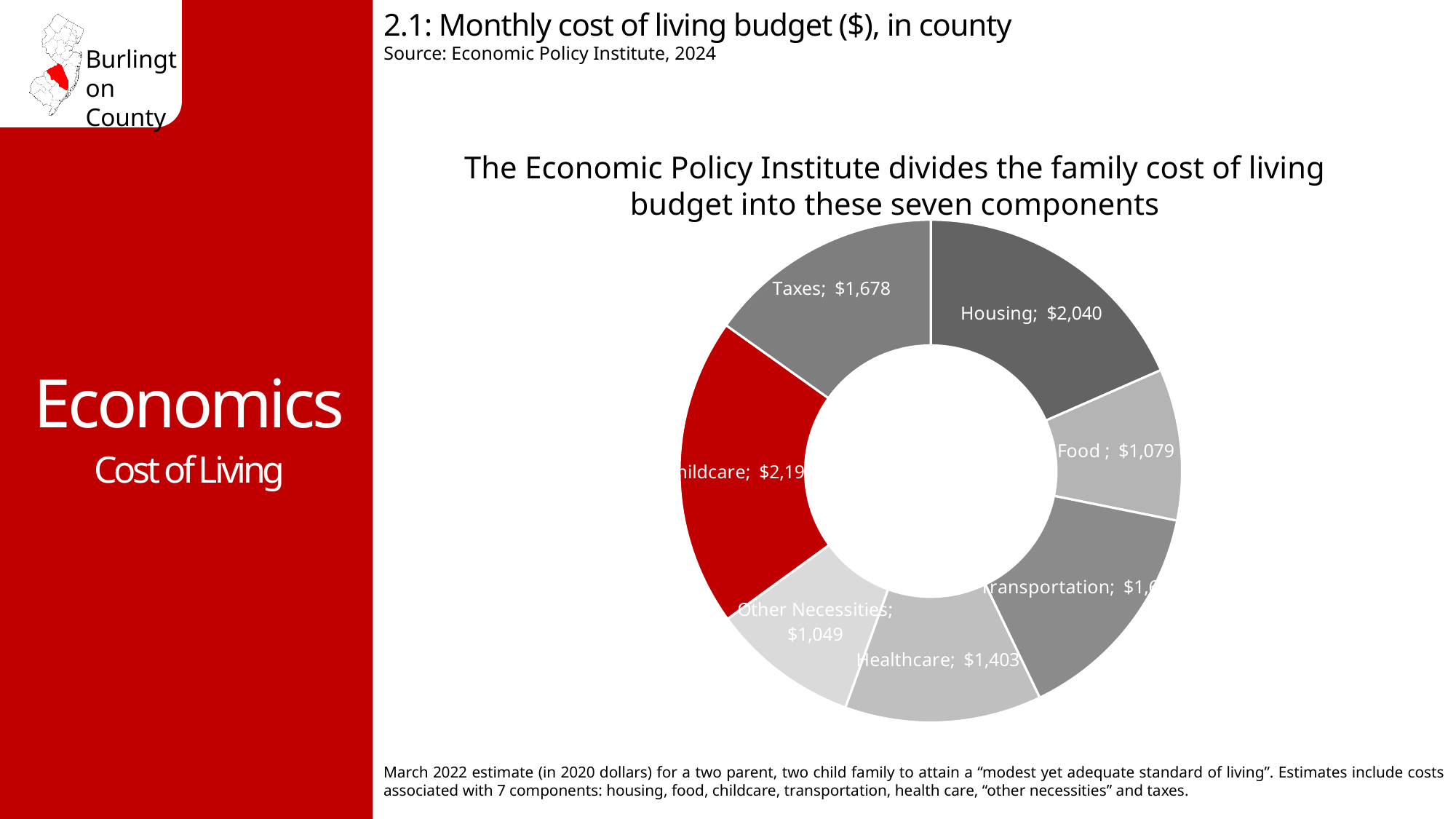
What is the monthly cost for Food shown on the chart? $1,079 What is the monthly cost for Housing shown on the chart? $2,040 What is the monthly cost for Healthcare shown on the chart? $1,403 What is the difference between the Housing and Taxes monthly costs? $362 What is the monthly cost for Other Necessities shown on the chart? $1,049 What is the monthly cost for Taxes shown on the chart? $1,678 What is the difference between the Healthcare and Food monthly costs? $324 Which is larger, the monthly cost for Food or for Other Necessities? Food Which component is shown in red on the chart? Childcare What kind of chart is shown on the slide? Donut (pie) chart Which component has the largest monthly cost on the chart? Childcare How many components (slices) does the chart show? 7